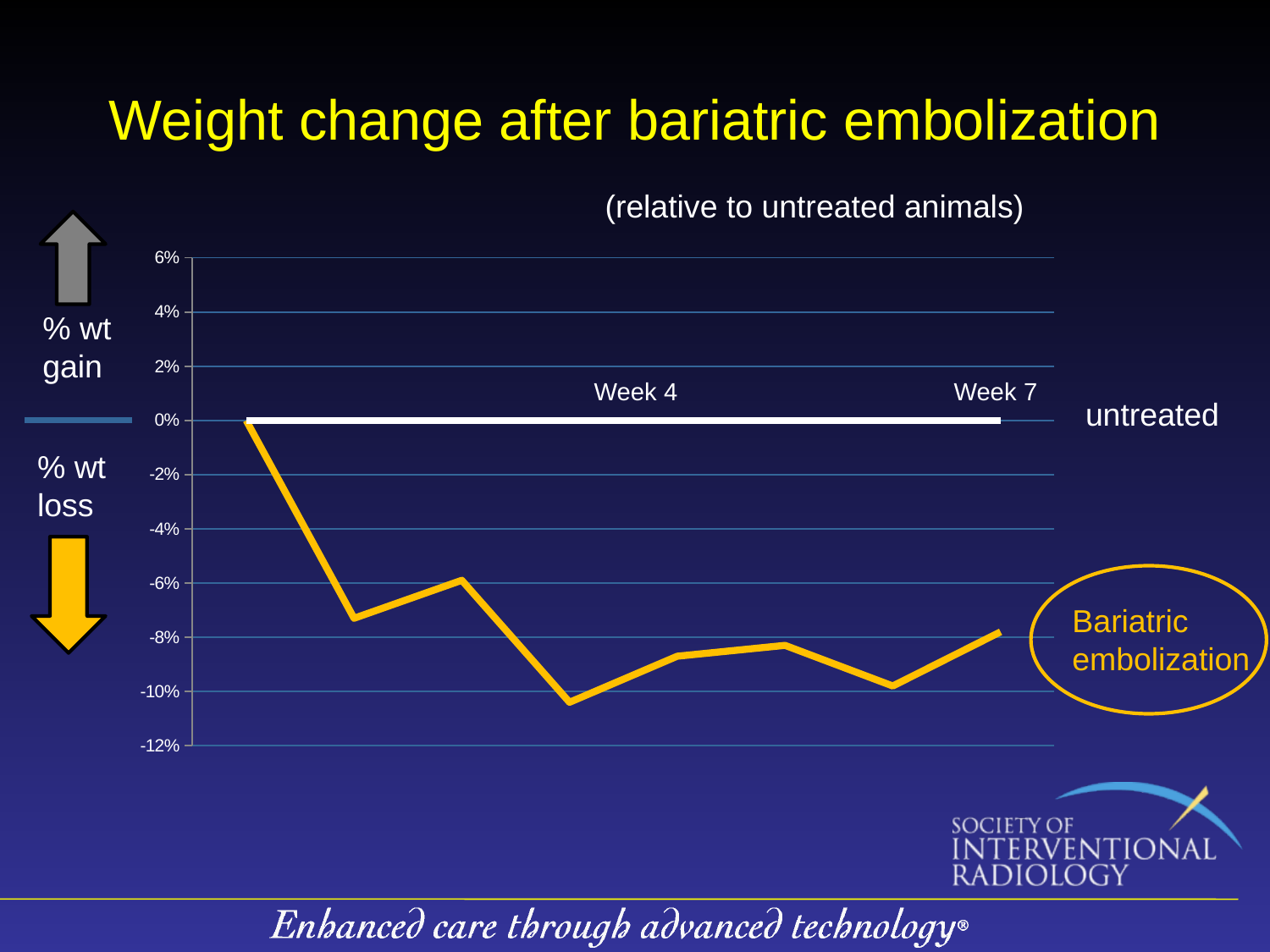
Is the value for Bariatric embolization at Week 4 greater or less than -8%? less What colour is the Bariatric embolization line? yellow How many series are plotted on the chart? 2 What is the title of the chart on the slide? Weight change after bariatric embolization What is the lowest value shown on the vertical axis? -12% What value does the untreated line stay at across the chart? 0% Is the value for Bariatric embolization at Week 7 greater or less than -10%? greater At which labelled week does the Bariatric embolization line reach its lowest point? Week 4 Does the Bariatric embolization line rise or fall from its starting point to Week 4? fall Which series has the higher value at Week 7, untreated or Bariatric embolization? untreated What kind of chart is shown on the slide? line chart At what value does the Bariatric embolization line start? 0%